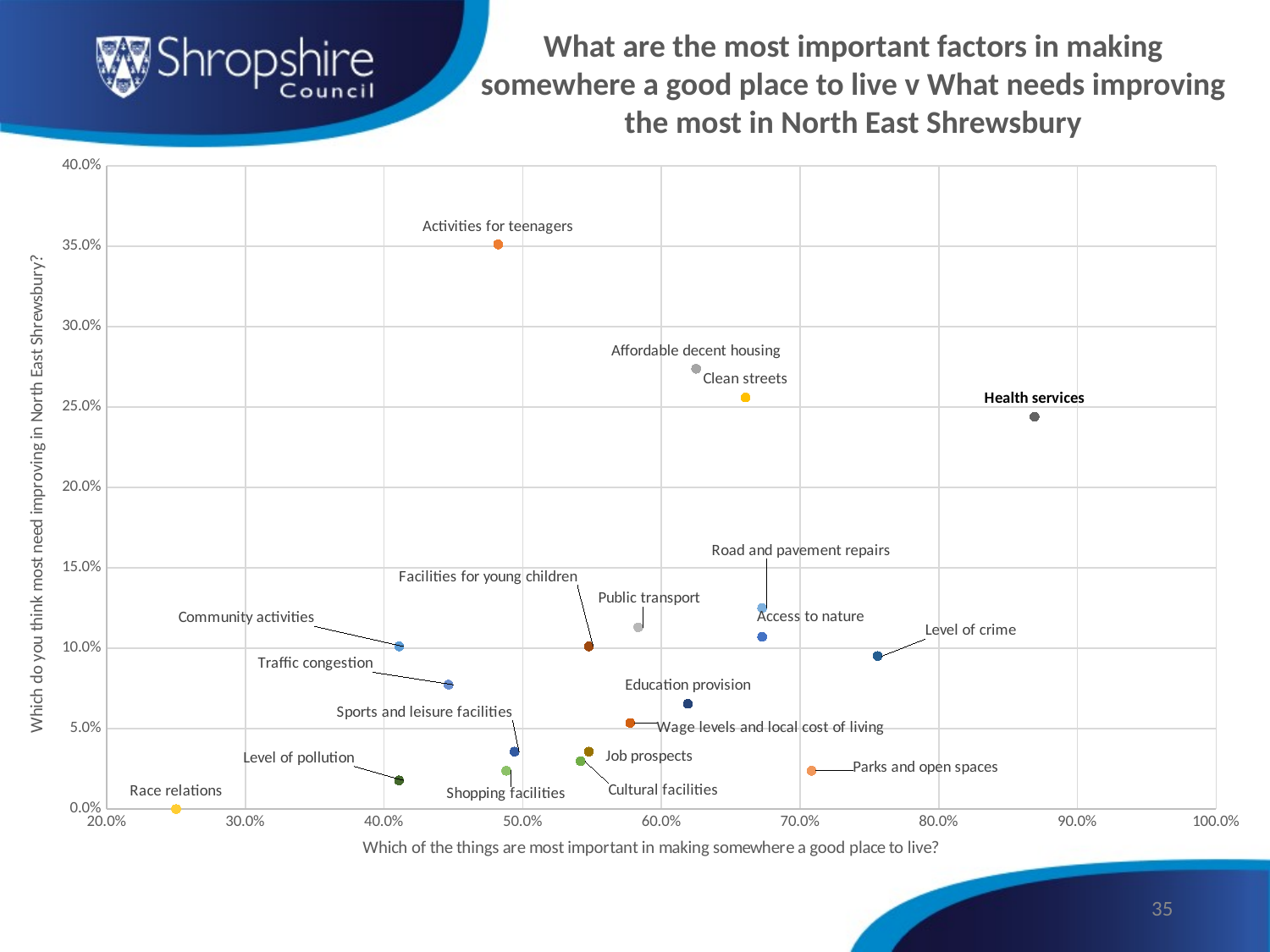
Which factor has the lowest value on the vertical axis (most need improving)? Race relations Is the horizontal-axis value for Health services greater or less than 80.0%? greater Which factor has the highest value on the horizontal axis (most important in making somewhere a good place to live)? Health services How many labelled data points are plotted on the chart? 20 Is the horizontal-axis value for Race relations greater or less than 30.0%? less What is the title of the horizontal axis? Which of the things are most important in making somewhere a good place to live? What is the title of the vertical axis? Which do you think most need improving in North East Shrewsbury? Which factor has the lowest value on the horizontal axis (most important in making somewhere a good place to live)? Race relations Which has the higher vertical-axis value, Affordable decent housing or Level of crime? Affordable decent housing Is the vertical-axis value for Activities for teenagers greater or less than 30.0%? greater What kind of chart is shown on the slide? Scatter chart Which factor has the highest value on the vertical axis (most need improving)? Activities for teenagers